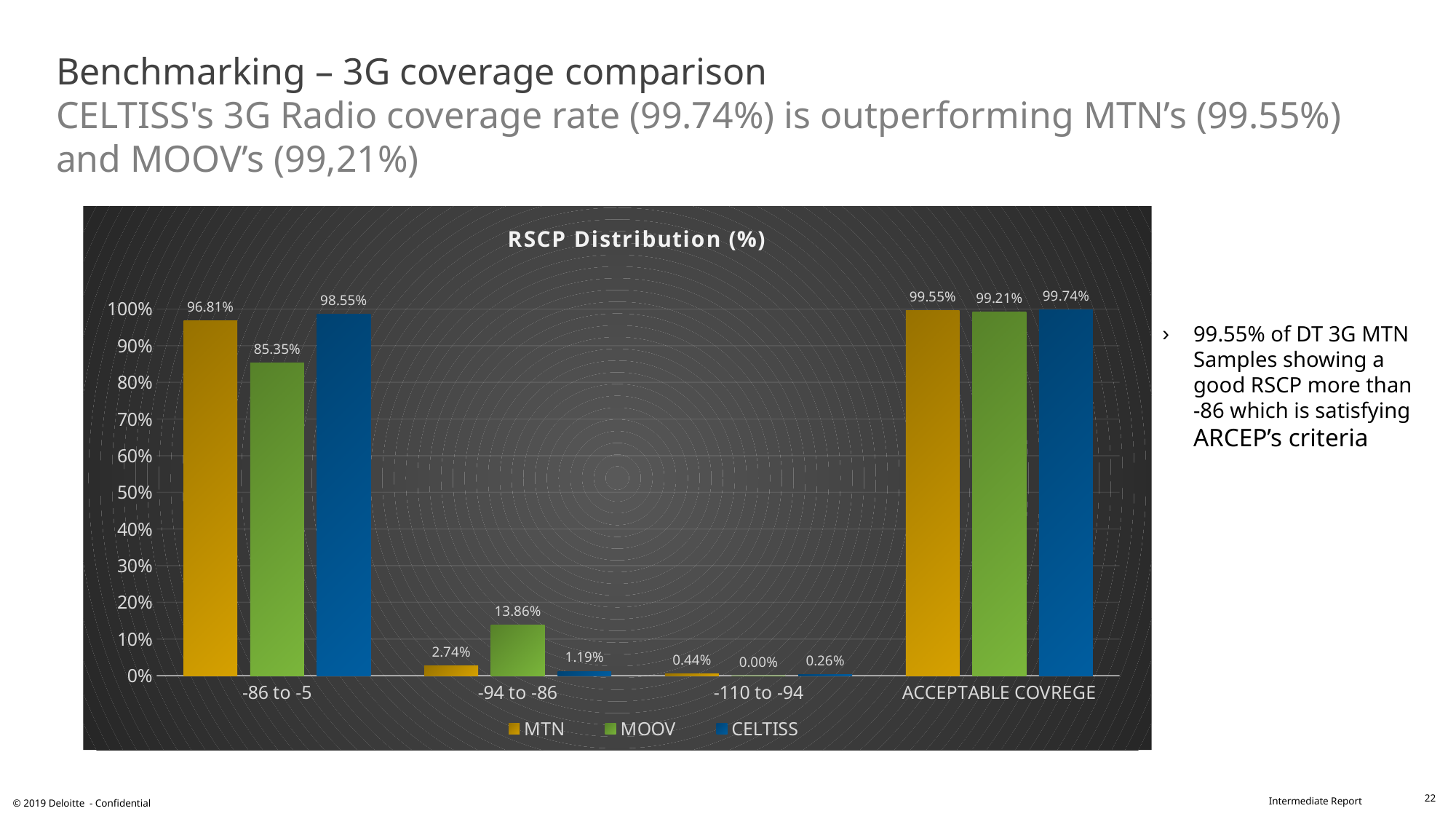
What is the MTN value for the -94 to -86 category? 2.74% Which is larger in the -110 to -94 category, the MTN value or the CELTISS value? MTN What is the CELTISS value for ACCEPTABLE COVREGE? 99.74% What kind of chart is shown? Bar chart What is the MOOV value for the -110 to -94 category? 0.00% How many series does the legend list? 3 Which series has the lowest value in the -86 to -5 category? MOOV What is the difference between the CELTISS and MTN values in the -86 to -5 category? 1.74% What is the title of the chart? RSCP Distribution (%) Which series has the highest value in the -94 to -86 category? MOOV What is the MOOV value for the -86 to -5 category? 85.35% How many categories are shown on the x axis? 4